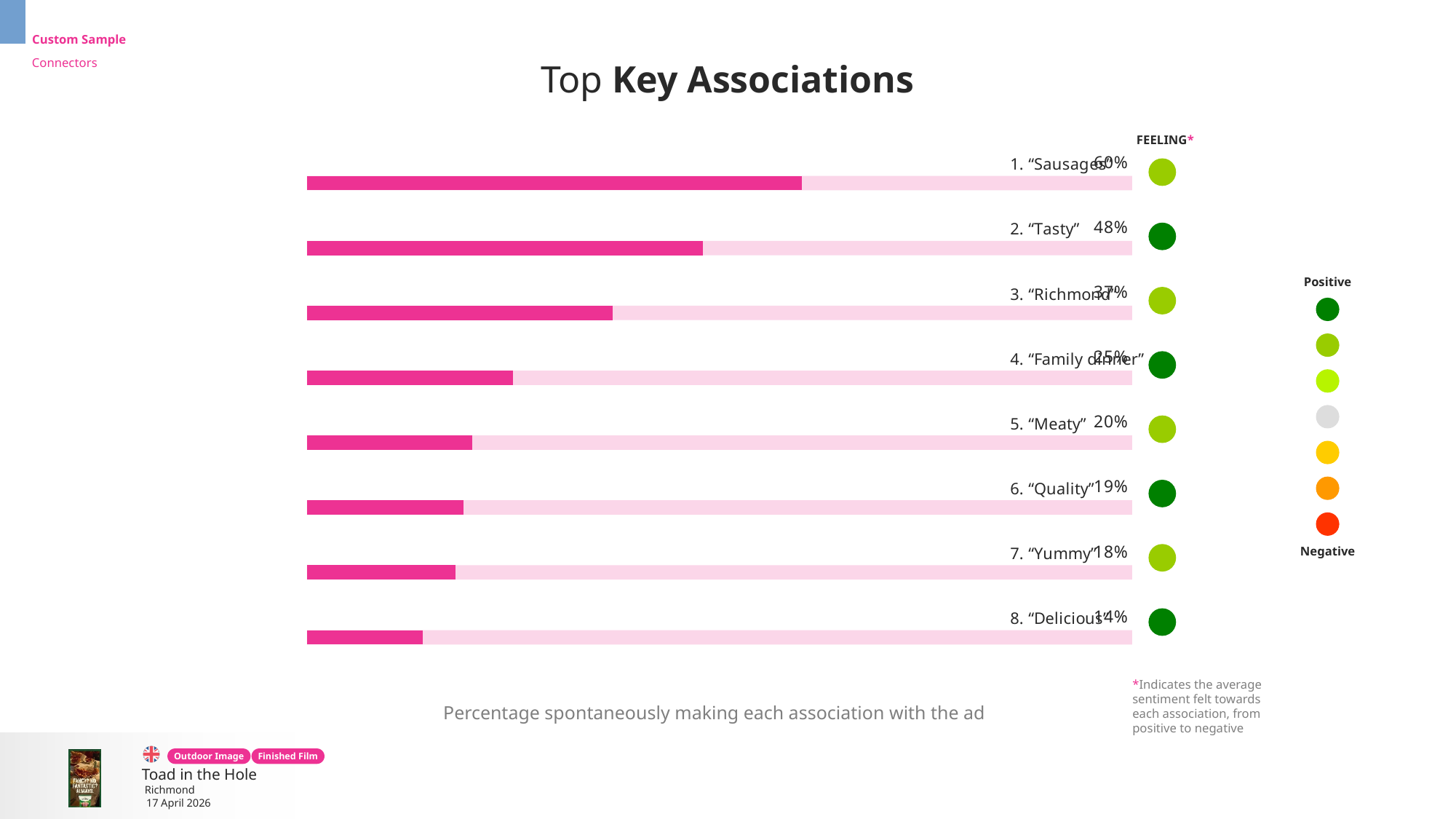
Do the percentages increase or decrease going down the list from association 1 to association 8? Decrease Which association has the lowest percentage? Delicious What percentage is shown for "Meaty"? 20% How many associations are listed in the chart? 8 What percentage of respondents spontaneously associated "Sausages" with the ad? 60% What is the value shown for "Tasty"? 48% What is the difference between the percentages for "Sausages" and "Tasty"? 12% What kind of chart is shown on the slide? Bar chart Which has a higher percentage, "Tasty" or "Richmond"? Tasty What is the difference between the values for "Richmond" and "Family dinner"? 12% Which association has the highest percentage? Sausages What is the value for "Delicious"? 14%